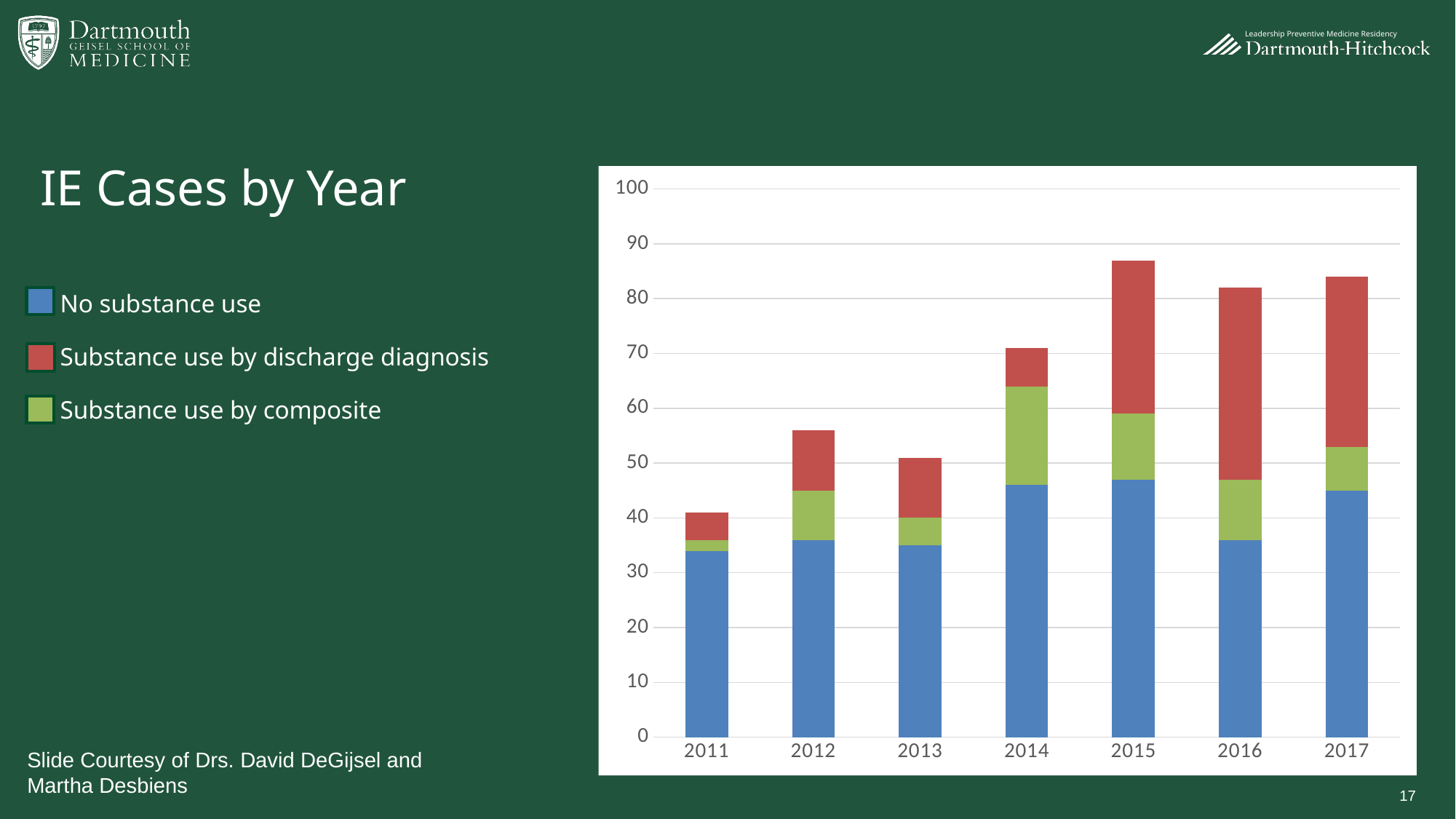
How many years are shown on the x axis of the chart? 7 Is the total bar height for 2015 greater or less than 80? greater Which colour represents 'No substance use' in the chart? Blue Is the total bar height for 2011 greater or less than 50? less Which year has the shortest stacked bar (lowest total IE cases)? 2011 Is the total bar height for 2013 greater or less than 60? less How many series does the legend list? 3 Which year has the tallest stacked bar (highest total IE cases)? 2015 What kind of chart is shown on the slide? Stacked bar chart Which year has a taller stacked bar, 2013 or 2014? 2014 Which series forms the bottom segment of each stacked bar? No substance use